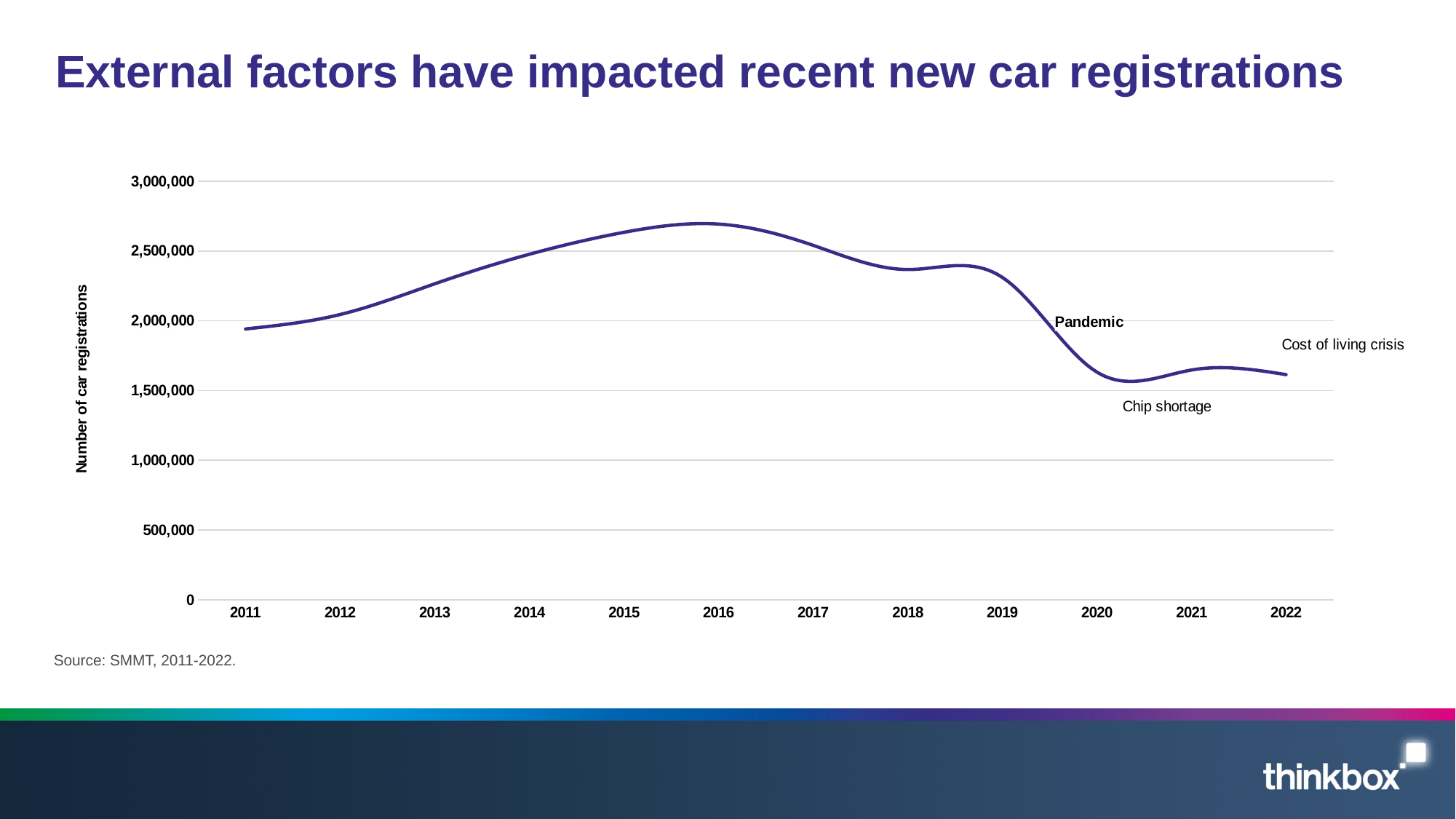
Is the value for 2016 greater or less than 2,500,000? greater Is the value for 2022 greater or less than 2,000,000? less How many years are plotted along the x axis? 12 Is the value for 2011 greater or less than 2,000,000? less Which year has the highest number of car registrations? 2016 Do car registrations rise or fall from 2011 to 2016? rise Do car registrations rise or fall from 2019 to 2020? fall Which year has more car registrations, 2016 or 2020? 2016 What is the label on the vertical axis? Number of car registrations What kind of chart is shown on the slide? line chart